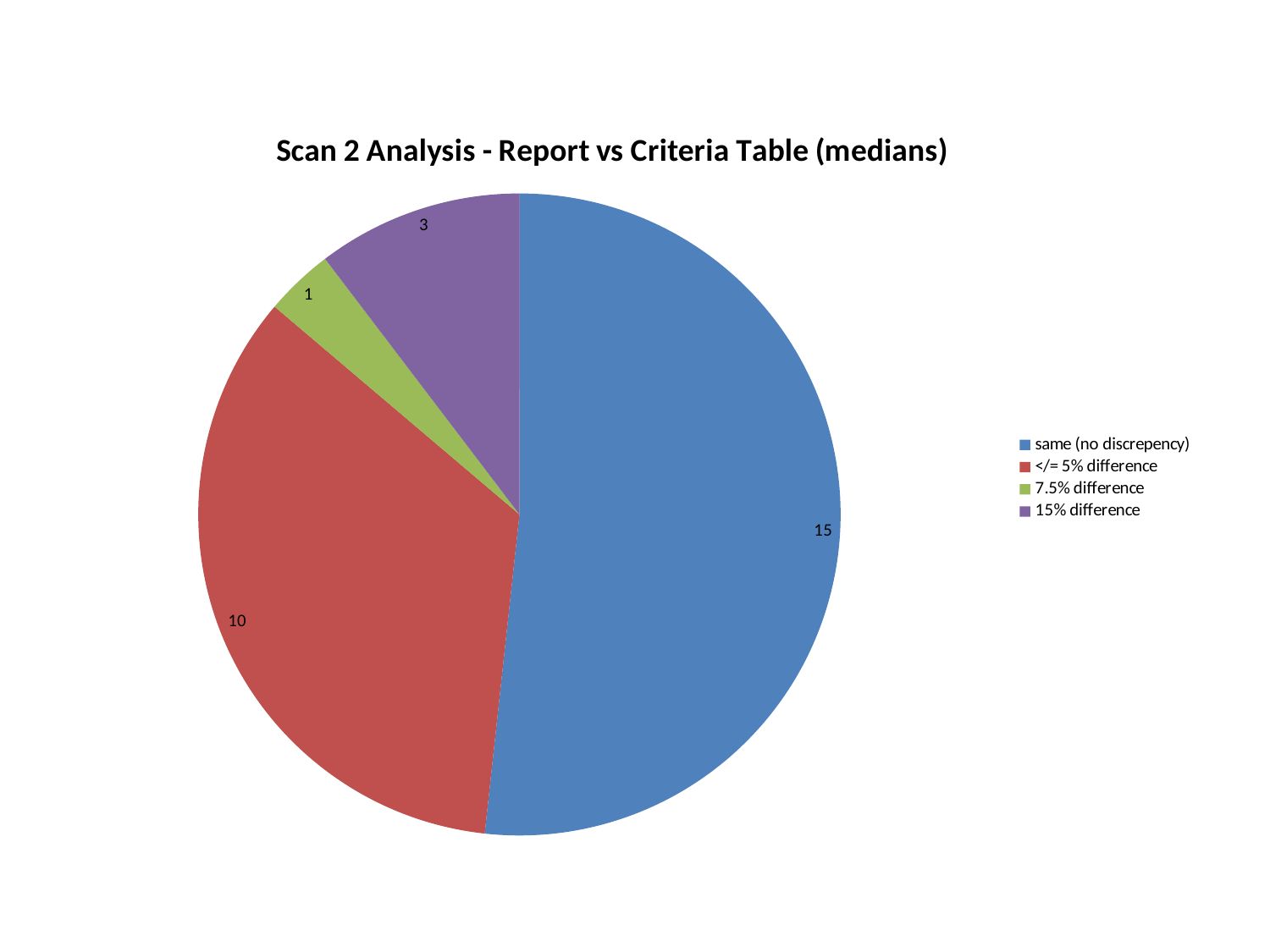
What is the total of all slices in the pie chart? 29 Which is larger, "15% difference" or "7.5% difference"? 15% difference What is the difference between the values for "same (no discrepency)" and "</= 5% difference"? 5 How many categories does the pie chart have? 4 What is the value for "15% difference"? 3 What is the value for "same (no discrepency)"? 15 What is the value for "</= 5% difference"? 10 Which category has the largest slice? same (no discrepency) What is the value for "7.5% difference"? 1 What is the title of the chart? Scan 2 Analysis - Report vs Criteria Table (medians) Which category has the smallest slice? 7.5% difference What kind of chart is shown on the slide? pie chart